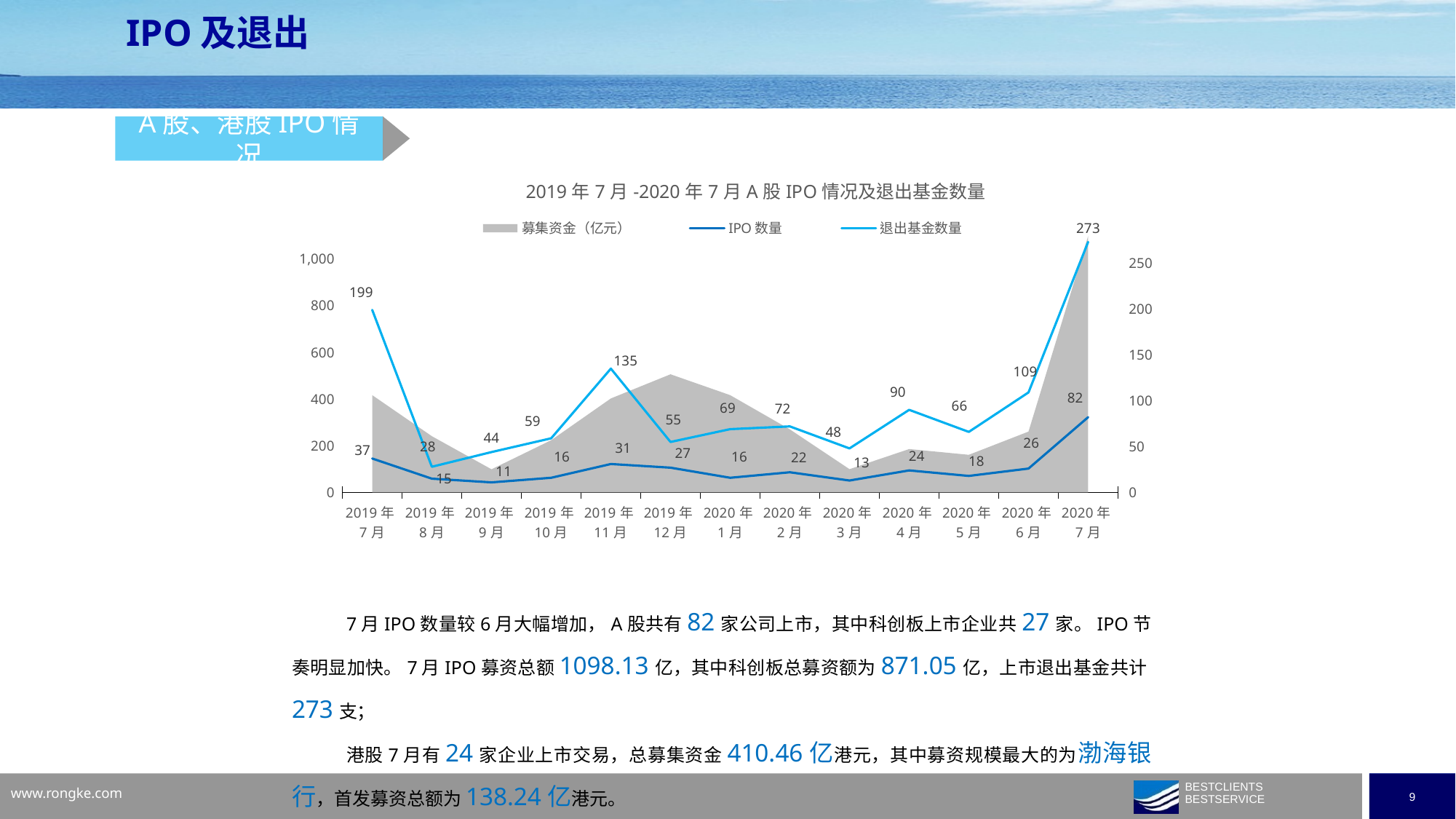
What is the difference between the 退出基金数量 values for 2020年7月 and 2019年7月? 74 Which month has the lowest IPO数量? 2019年9月 Is the 募集资金（亿元） value for 2020年7月 greater or less than 800? greater What is the 退出基金数量 value for 2019年11月? 135 How many months are shown on the x axis of the chart? 13 How many series does the chart legend list? 3 What is the IPO数量 value for 2019年9月? 11 Which month has the highest 退出基金数量? 2020年7月 What is the IPO数量 value for 2020年7月? 82 What is the title of the chart? 2019年7月-2020年7月A股IPO情况及退出基金数量 Does the IPO数量 rise or fall from 2020年3月 to 2020年7月? rise Which is larger, the IPO数量 for 2019年7月 or for 2019年11月? 2019年7月